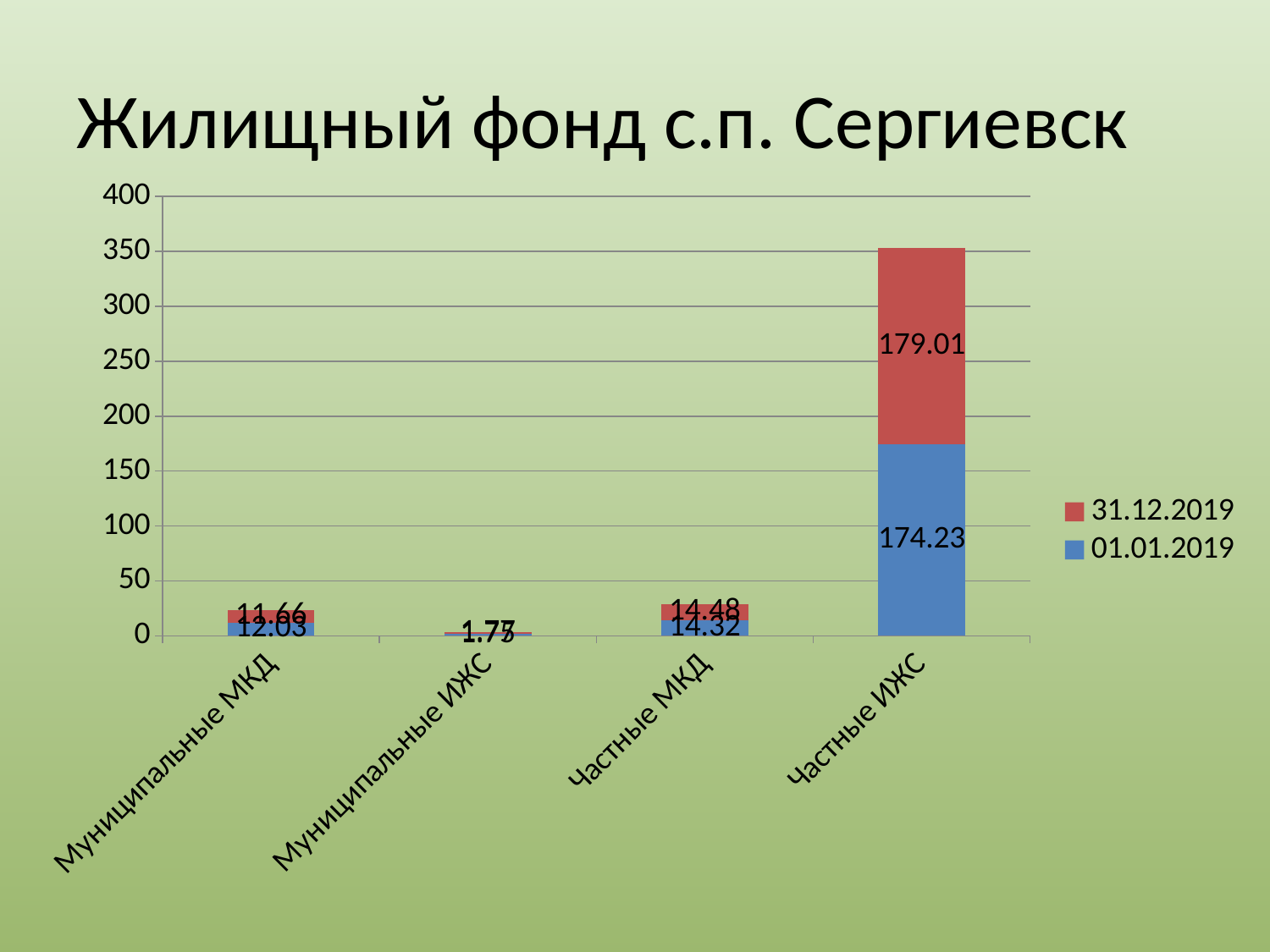
Which category has the lowest stacked bar? Муниципальные ИЖС What kind of chart is shown on the slide? Stacked bar chart What is the value for Частные МКД in the 01.01.2019 series? 14.32 What is the value for Частные МКД in the 31.12.2019 series? 14.48 What is the total of the stacked bar for Частные ИЖС? 353.24 What is the value for Частные ИЖС in the 31.12.2019 series? 179.01 What is the value for Частные ИЖС in the 01.01.2019 series? 174.23 How many categories are shown on the x axis? 4 Which category has the highest stacked bar? Частные ИЖС What is the title of the chart? Жилищный фонд с.п. Сергиевск How many series does the legend list? 2 What is the difference between the 31.12.2019 and 01.01.2019 values for Частные ИЖС? 4.78